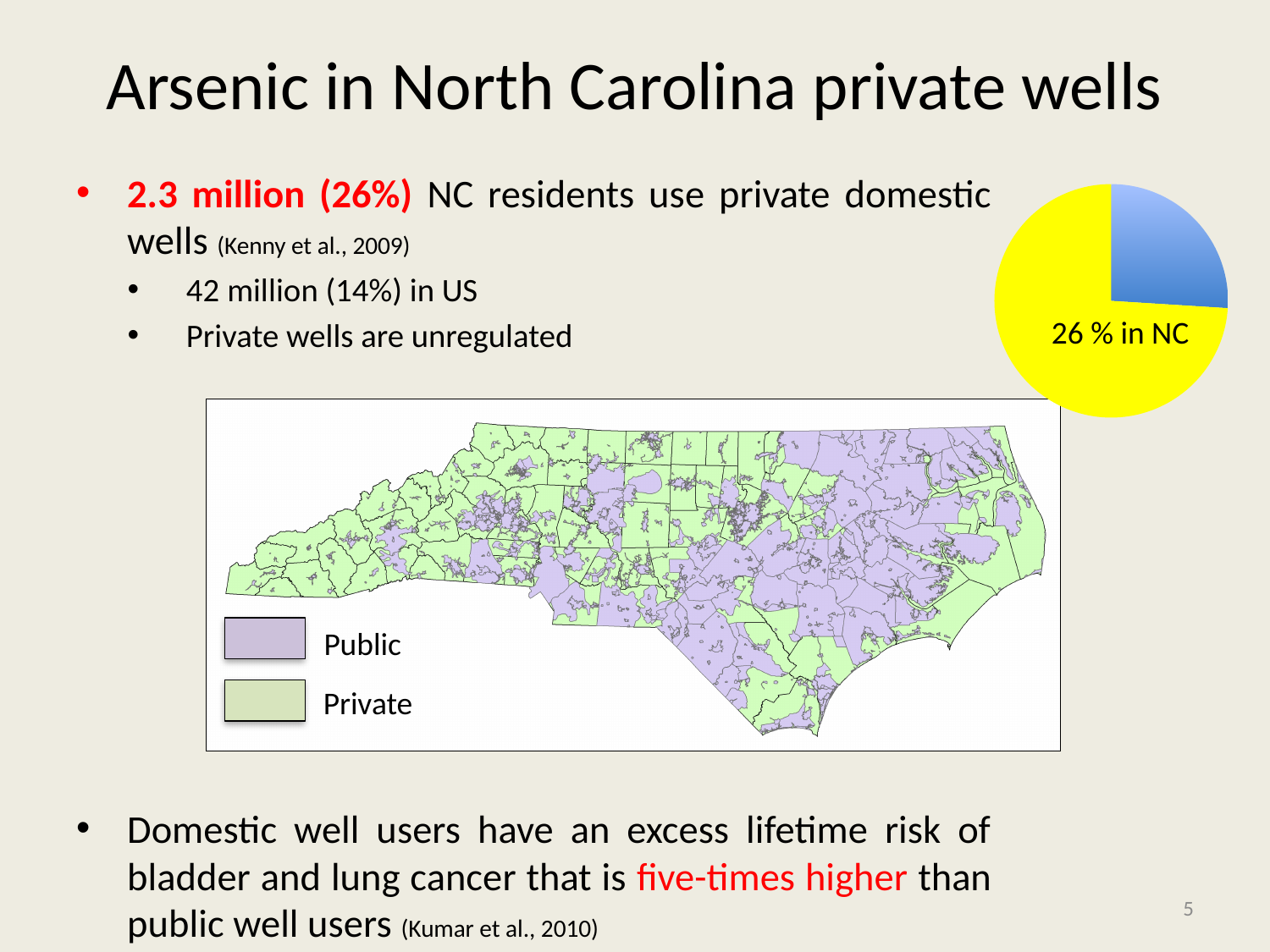
Does the pie chart have a legend? No Which slice of the pie chart is larger, the yellow one or the blue one? yellow How many slices does the pie chart have? 2 Which slice of the pie chart is the smallest? blue What kind of chart is shown in the top right of the slide? pie chart What two colours are used for the slices of the pie chart? yellow and blue Is the blue slice of the pie chart greater or less than 50% of the pie? less What percentage is printed on the pie chart? 26 % in NC What share of the pie chart does the larger slice represent, given the smaller slice is 26%? 74%